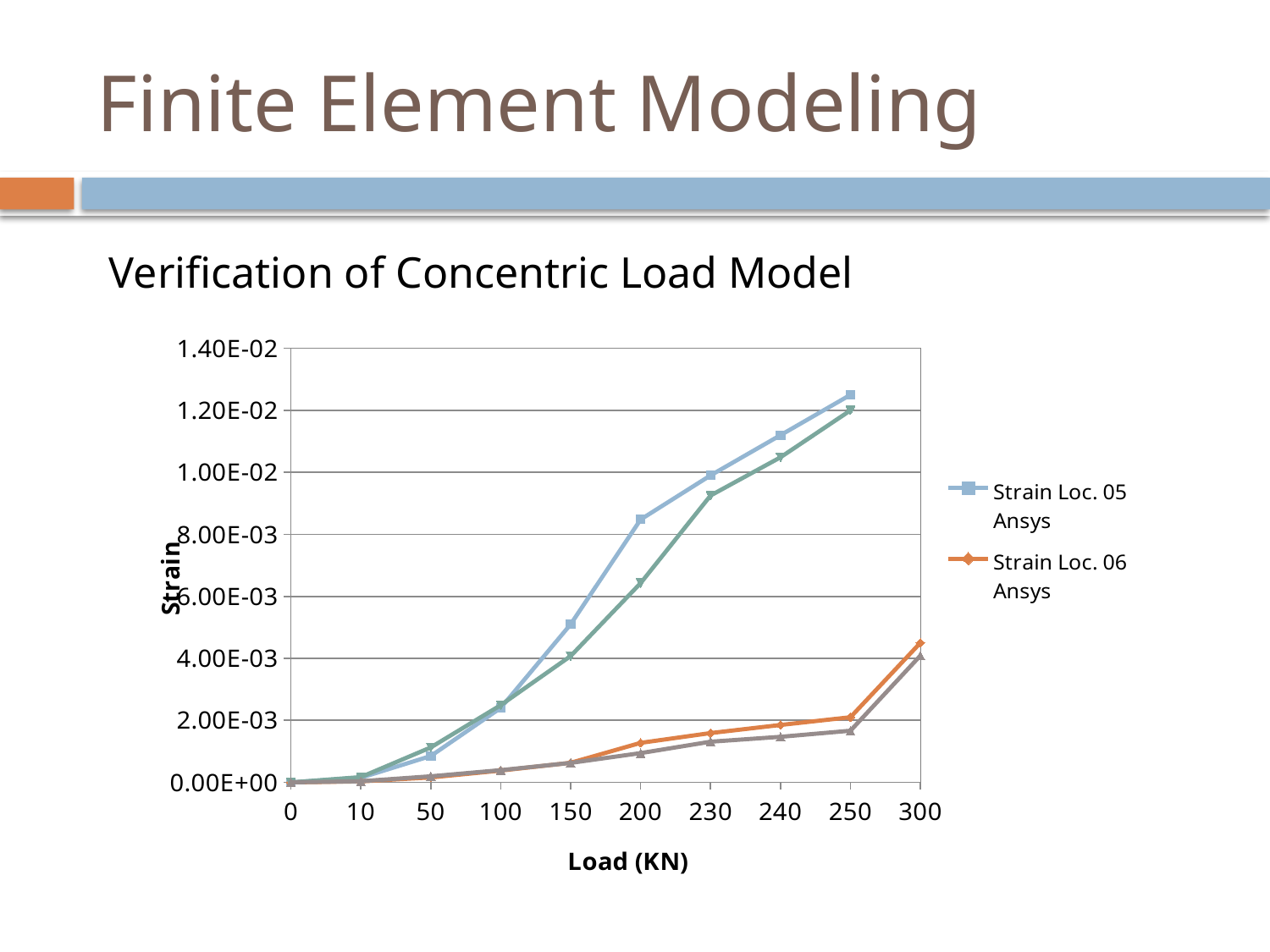
What kind of chart is shown on the slide? line chart How many series does the chart legend list? 2 Is the value for Strain Loc. 06 Ansys at a load of 200 greater or less than 2.00E-03? less What is the title of the y axis of the chart? Strain Do the strain values for Strain Loc. 06 Ansys rise or fall as the load increases along the x axis? rise Is the value for Strain Loc. 05 Ansys at a load of 150 greater or less than 6.00E-03? less Is the value for Strain Loc. 05 Ansys at a load of 250 greater or less than 1.20E-02? greater What is the title of the x axis of the chart? Load (KN) At a load of 200, which series has the larger strain, Strain Loc. 05 Ansys or Strain Loc. 06 Ansys? Strain Loc. 05 Ansys How many load values are marked along the x axis of the chart? 10